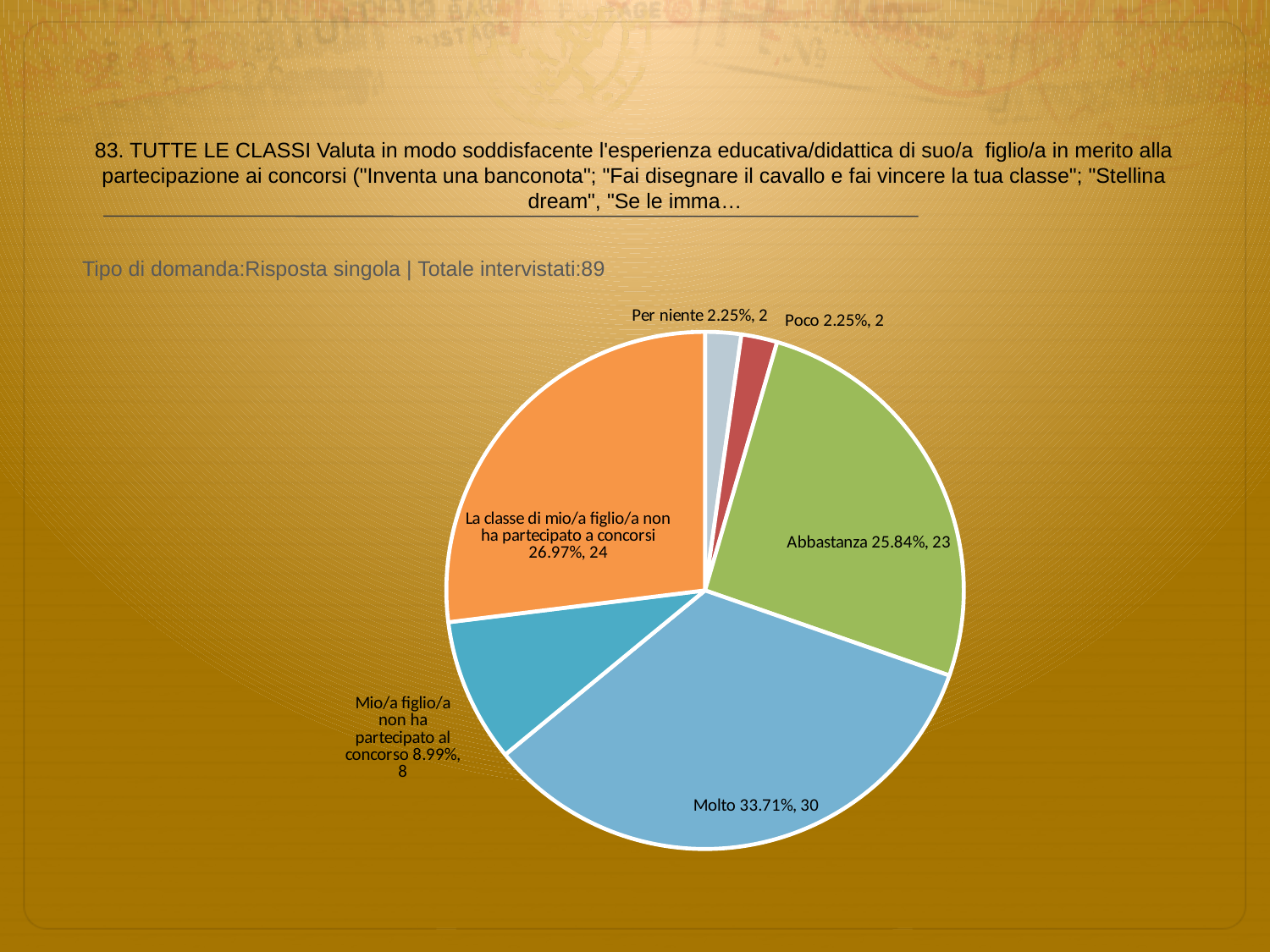
What percentage share does the "Molto" slice have? 33.71% What percentage share does "Mio/a figlio/a non ha partecipato al concorso" have? 8.99% What colour is the "Molto" slice? light blue What is the total number of respondents stated on the slide? 89 What kind of chart is shown on the slide? pie chart How many respondents answered "Abbastanza"? 23 How many respondents answered "Poco"? 2 How many slices does the pie chart have? 6 Which is larger, the count for "Abbastanza" or the count for "La classe di mio/a figlio/a non ha partecipato a concorsi"? La classe di mio/a figlio/a non ha partecipato a concorsi Which category has the largest slice? Molto What is the difference in count between "Molto" and "Abbastanza"? 7 What is the count for "La classe di mio/a figlio/a non ha partecipato a concorsi"? 24